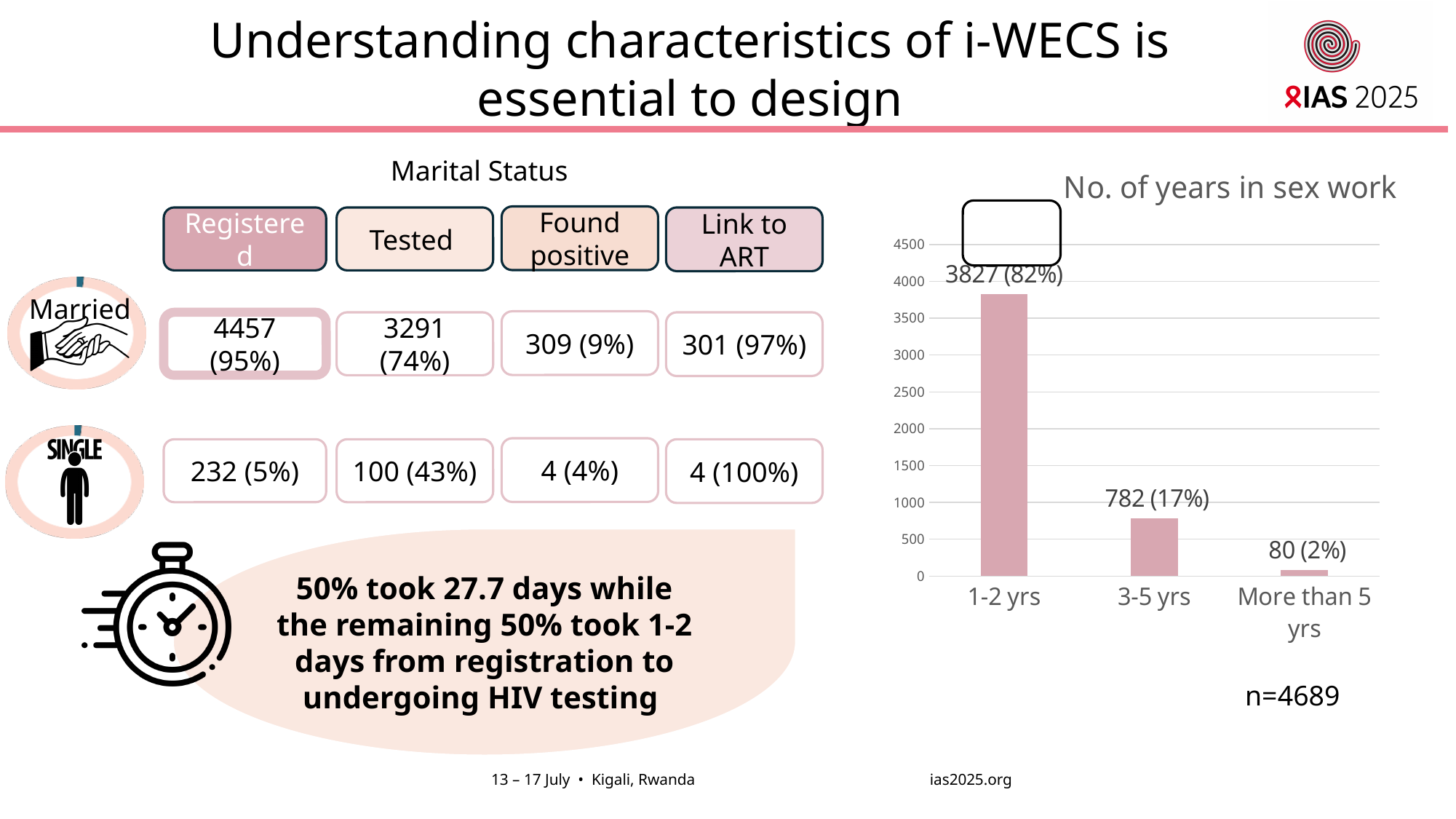
In the "No. of years in sex work" chart, how many categories are shown on the x axis? 3 In the "No. of years in sex work" chart, what is the data label for the 1-2 yrs bar? 3827 (82%) In the "No. of years in sex work" chart, what is the difference between the counts for 3-5 yrs and More than 5 yrs? 702 In the "No. of years in sex work" chart, which category has the highest value? 1-2 yrs In the "No. of years in sex work" chart, what is the data label for the 3-5 yrs bar? 782 (17%) In the "No. of years in sex work" chart, do the values rise or fall from left to right along the x axis? fall In the "No. of years in sex work" chart, is the value for 3-5 yrs greater or less than 1000? less In the "No. of years in sex work" chart, which category has the lowest value? More than 5 yrs In the "No. of years in sex work" chart, what is the difference between the counts for 1-2 yrs and 3-5 yrs? 3045 What kind of chart is shown under the title "No. of years in sex work"? bar chart In the "No. of years in sex work" chart, what is the data label for the More than 5 yrs bar? 80 (2%) What is the title of the bar chart on the right of the slide? No. of years in sex work